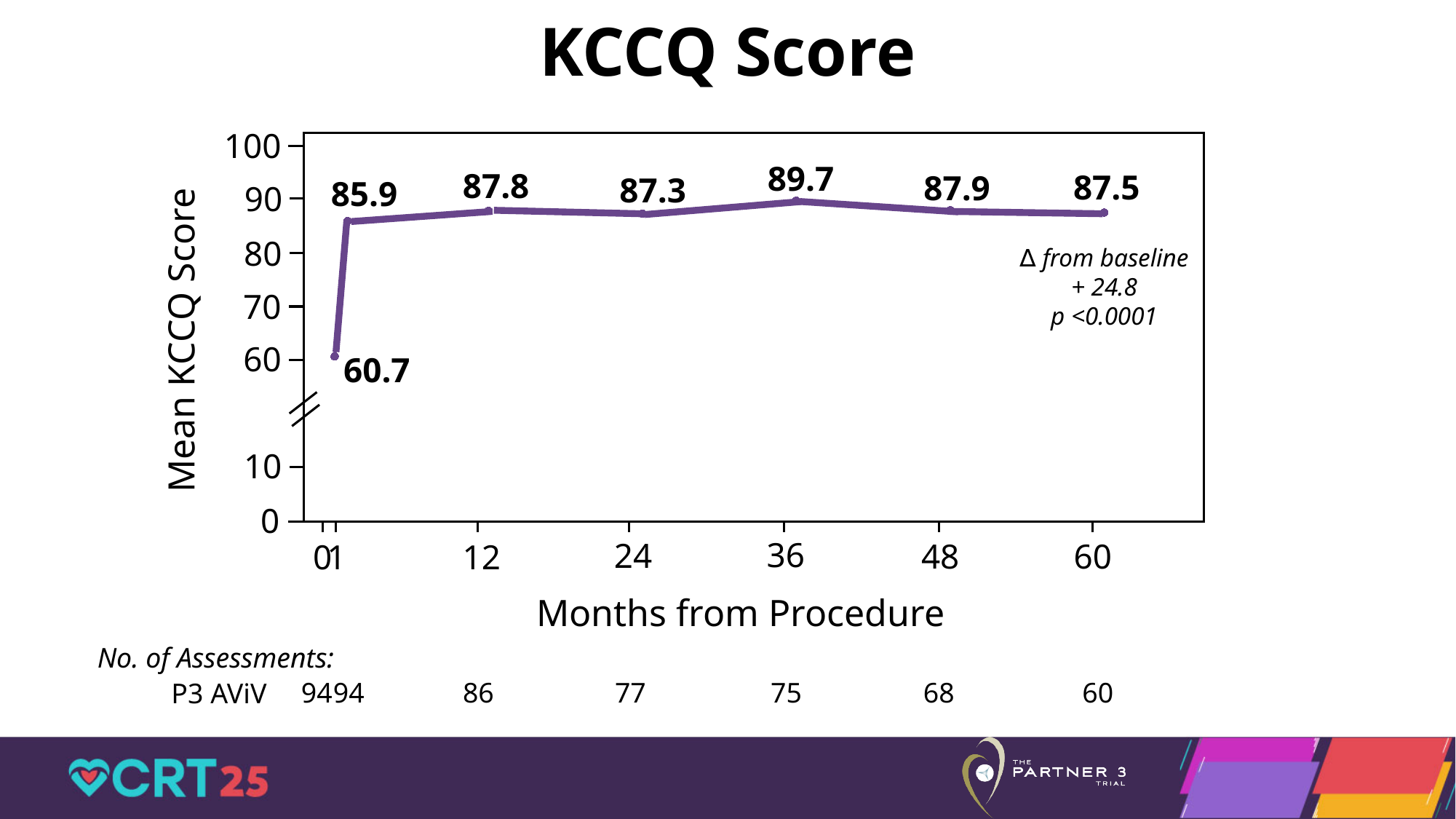
What is the mean KCCQ score at 36 months from procedure? 89.7 At which time point is the mean KCCQ score lowest? Baseline (month 0) What is the difference between the mean KCCQ score at 36 months and at 24 months? 2.4 At which time point is the mean KCCQ score highest? 36 months How many time points are plotted on the line? 7 What is the mean KCCQ score at 60 months from procedure? 87.5 What kind of chart is shown on the slide? Line chart Which is larger, the mean KCCQ score at 12 months or at 24 months? 12 months What is the difference between the mean KCCQ score at 1 month and at baseline? 25.2 What is the mean KCCQ score at baseline (month 0)? 60.7 How many assessments were there at 60 months? 60 What is the change (Δ) from baseline stated on the chart? + 24.8